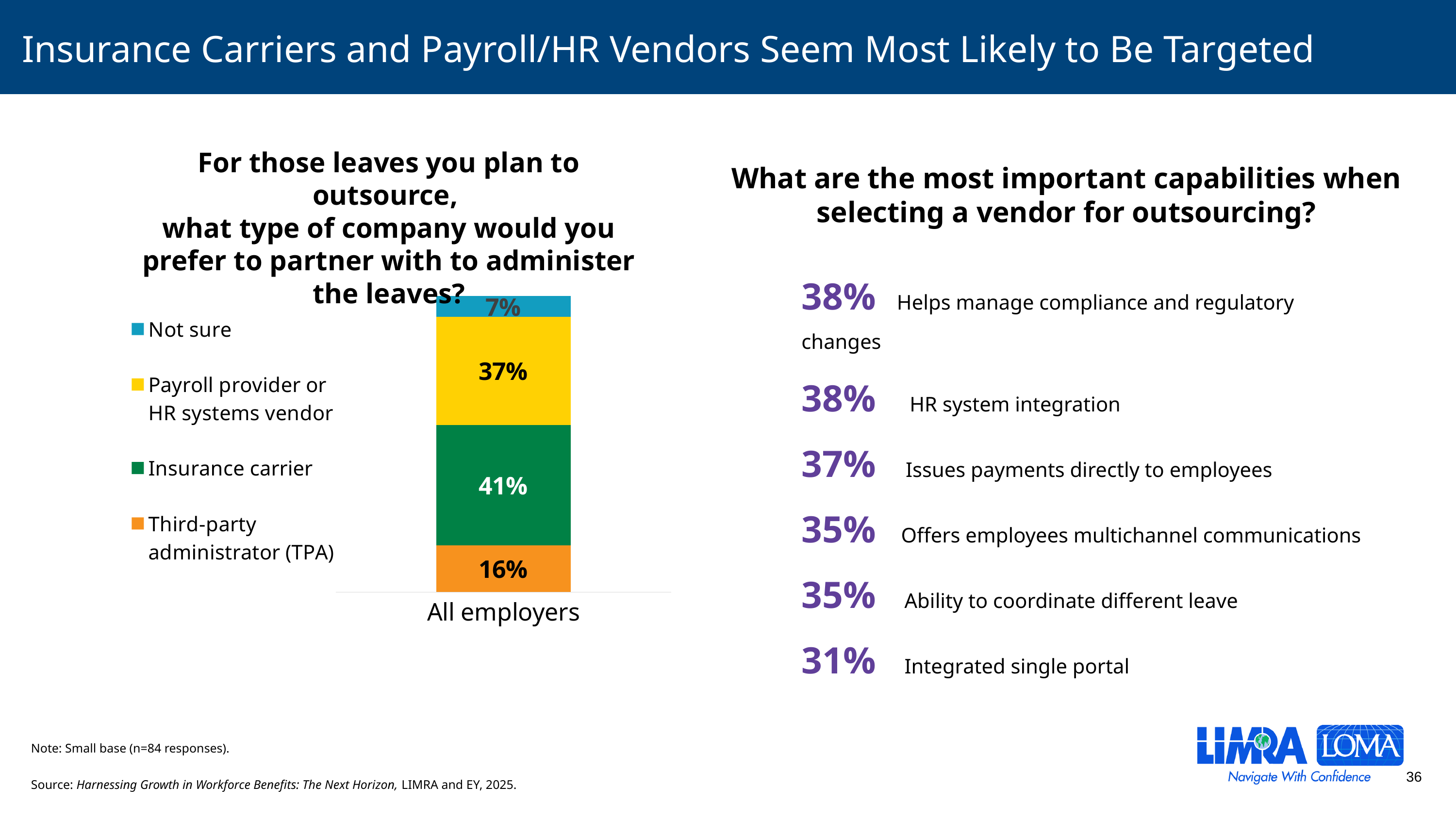
How many series does the legend of the stacked bar chart list? 4 What is the difference between the share for insurance carrier and the share for payroll provider or HR systems vendor? 4% What percentage of employers prefer to partner with an insurance carrier to administer outsourced leaves? 41% Which segment of the stacked bar is the smallest? Not sure What percentage of employers prefer a payroll provider or HR systems vendor? 37% What is the label of the single category on the x axis of the stacked bar chart? All employers What percentage of employers answered 'Not sure' about which type of company they would partner with? 7% Which type of company has the largest share in the stacked bar? Insurance carrier What percentage of employers prefer a third-party administrator (TPA)? 16% What kind of chart shows the preferred type of company to partner with? Stacked bar chart Which is larger: the share for insurance carrier or the share for third-party administrator (TPA)? Insurance carrier What is the difference between the share for third-party administrator (TPA) and the share for 'Not sure'? 9%